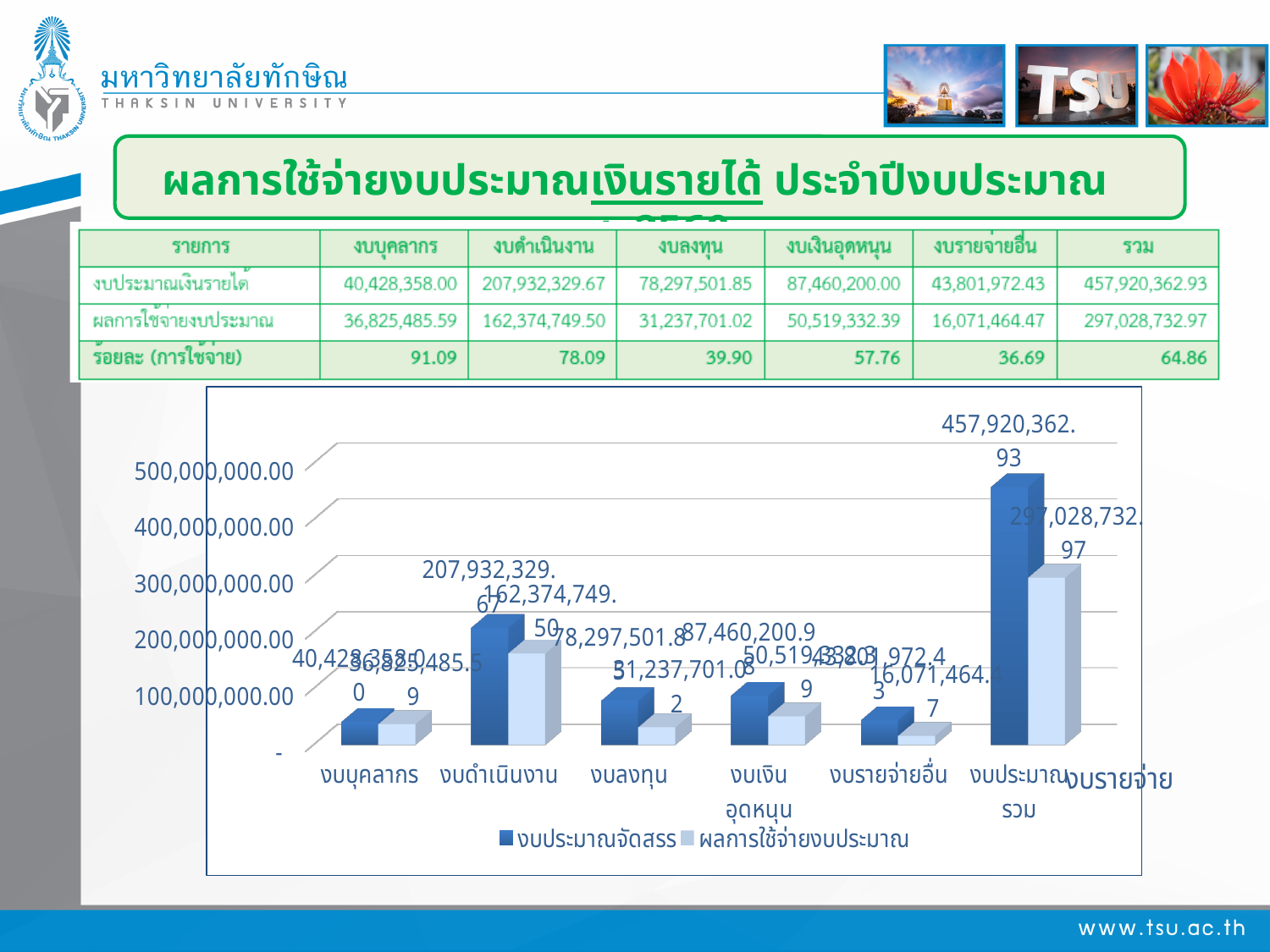
Which category has the highest งบประมาณจัดสรร bar in the chart? งบประมาณรวม Is the งบประมาณจัดสรร value for งบประมาณรวม greater or less than 400,000,000.00? greater What is the ผลการใช้จ่ายงบประมาณ value for งบประมาณรวม in the chart? 297,028,732.97 What is the งบประมาณจัดสรร value for งบดำเนินงาน in the chart? 207,932,329.67 What is the difference between the งบประมาณจัดสรร and ผลการใช้จ่ายงบประมาณ values for งบประมาณรวม? 160,891,629.96 Which category has the lowest ผลการใช้จ่ายงบประมาณ bar in the chart? งบรายจ่ายอื่น Which series is shown in dark blue in the chart? งบประมาณจัดสรร What is the งบประมาณจัดสรร value for งบประมาณรวม in the chart? 457,920,362.93 How many categories are shown along the x axis of the chart? 6 How many series does the chart legend list? 2 What kind of chart is shown on the slide? bar chart What is the difference between the งบประมาณจัดสรร and ผลการใช้จ่ายงบประมาณ values for งบดำเนินงาน? 45,557,580.17